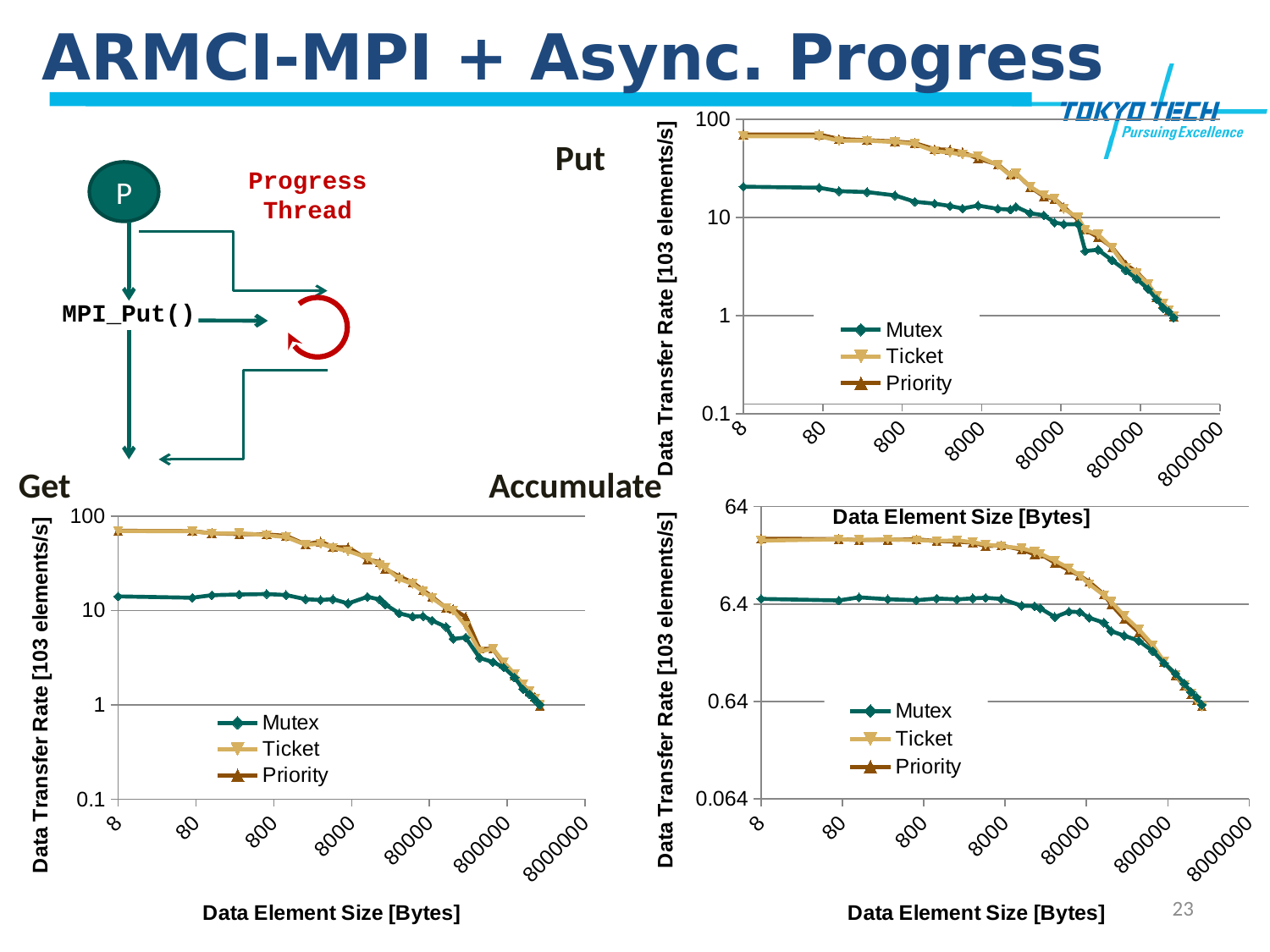
In the Accumulate chart, do the Ticket values rise or fall as the data element size increases? fall How many series does the legend of the Put chart list? 3 Which series are listed in the legend of the Get chart? Mutex, Ticket, Priority In the Accumulate chart, is the Ticket value at a data element size of 8 bytes greater or less than 6.4? greater In the Put chart, is the Mutex value at a data element size of 8 bytes greater or less than 10? greater In the Get chart, is the Mutex value at a data element size of 800000 bytes greater or less than 10? less In the Put chart, do the Mutex values rise or fall as the data element size increases? fall What kind of chart is the Put chart? line chart What is the x-axis title of the Get chart? Data Element Size [Bytes] In the Put chart, at a data element size of 8 bytes, which series has the larger value, Ticket or Mutex? Ticket